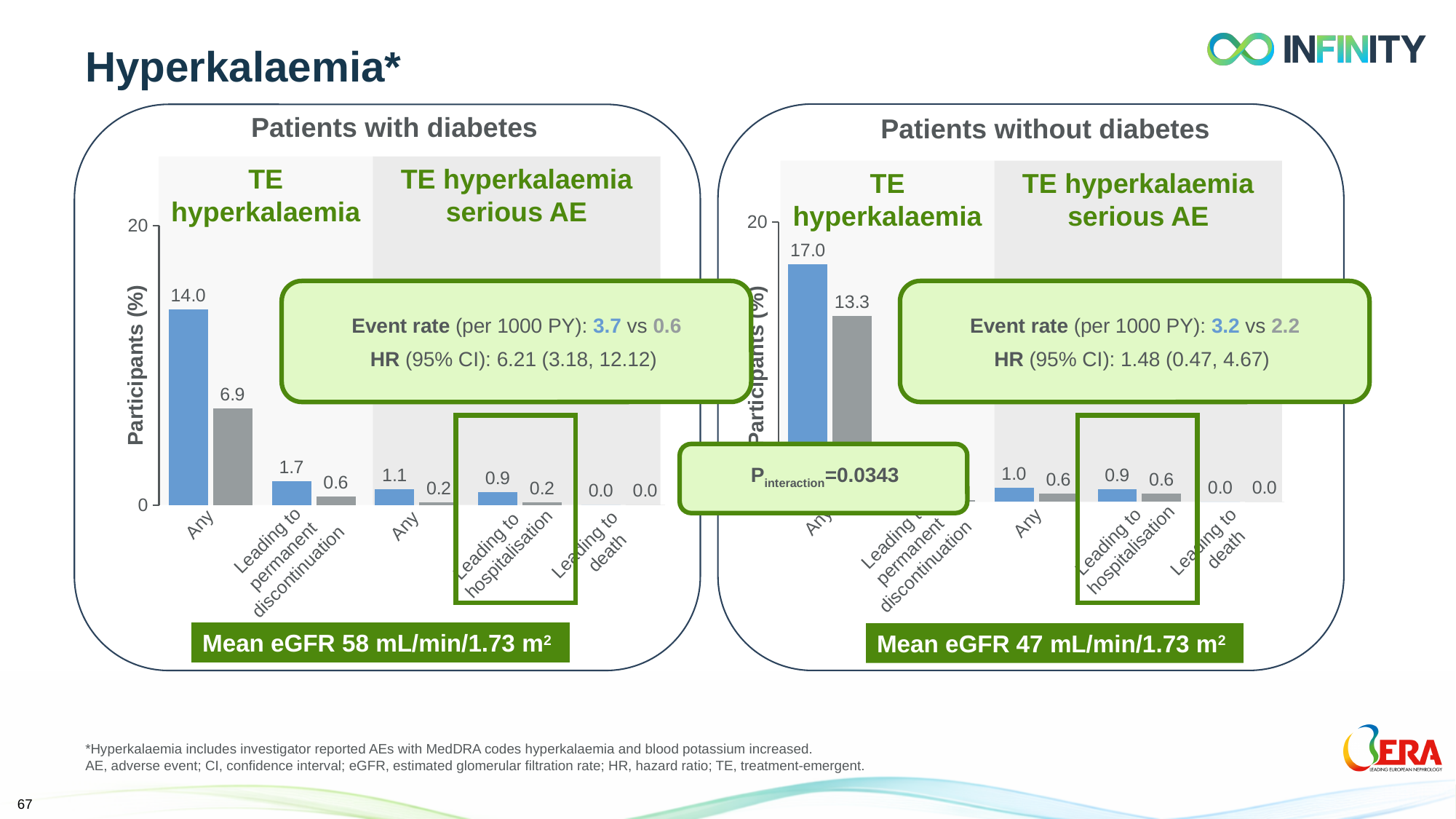
In the 'Patients without diabetes' chart, is the blue bar for 'Any' TE hyperkalaemia greater or less than 20? less In the 'Patients without diabetes' chart, what is the value of the blue bar for 'Any' TE hyperkalaemia? 17.0 In the 'Patients without diabetes' chart, what is the value of the grey bar for 'Any' TE hyperkalaemia? 13.3 In the 'Patients with diabetes' chart, what is the value of the grey bar for 'Any' TE hyperkalaemia? 6.9 In the 'Patients with diabetes' chart, what is the value of the blue bar for 'Any' TE hyperkalaemia? 14.0 In the 'Patients with diabetes' chart, which category has the highest blue bar? Any (TE hyperkalaemia) Which is larger: the blue bar for 'Any' TE hyperkalaemia in the 'Patients with diabetes' chart or in the 'Patients without diabetes' chart? Patients without diabetes What type of chart is used in the 'Patients with diabetes' panel? Bar chart In the 'Patients with diabetes' chart, what is the difference between the blue and grey bars for 'Any' TE hyperkalaemia? 7.1 In the 'Patients without diabetes' chart, what is the difference between the blue and grey bars for 'Any' TE hyperkalaemia? 3.7 What is the y-axis label of the 'Patients with diabetes' chart? Participants (%) In the 'Patients with diabetes' chart, what is the value of the blue bar for TE hyperkalaemia 'Leading to permanent discontinuation'? 1.7